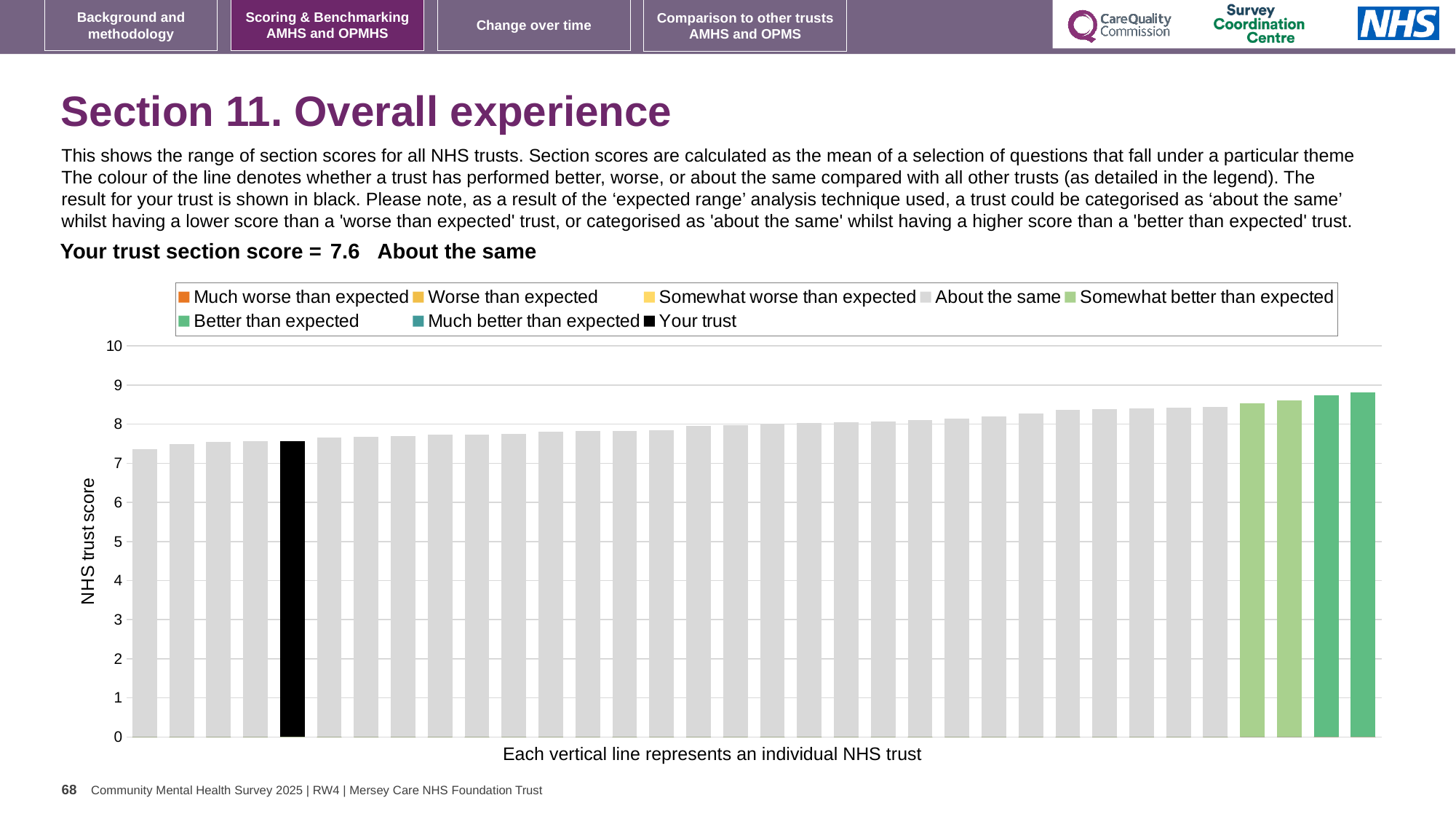
Which bar is the highest: the leftmost bar or the rightmost bar? rightmost bar Which category is your trust's section score placed in? About the same Is the value of the tallest bar (rightmost) greater or less than 8? greater How many entries does the chart legend list? 8 Is your trust's bar (black) higher or lower than the rightmost bar? lower What type of chart is shown on the slide? bar chart Is the value of the leftmost bar greater or less than 8? less How many bars are coloured green (somewhat better or better than expected)? 4 What is the label on the y axis of the chart? NHS trust score Is the value for your trust (the black bar) greater or less than 7? greater What is the section score for your trust shown on the slide? 7.6 Do the bar values rise or fall from left to right along the x axis? rise